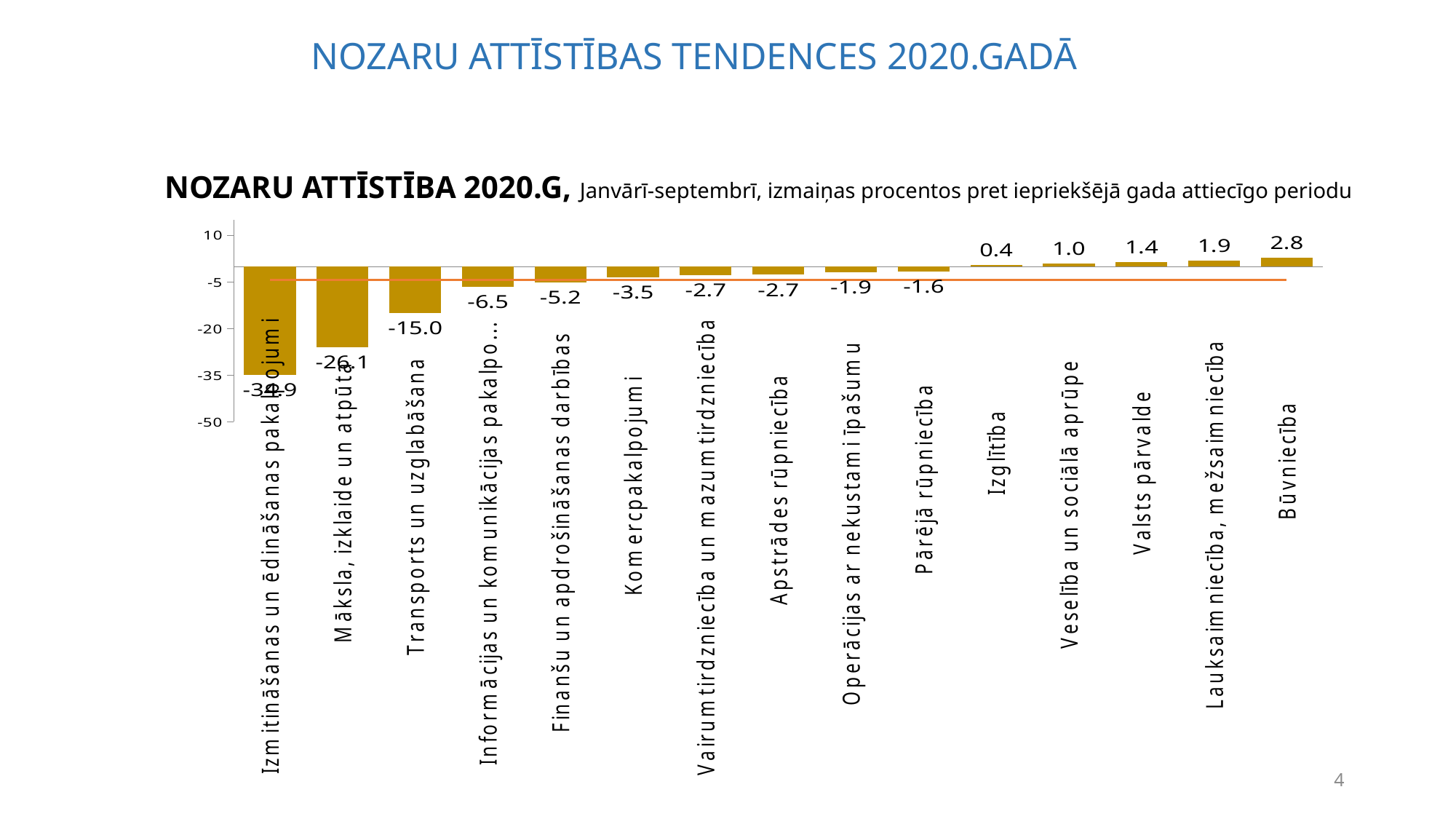
What is the value for Būvniecība? 2.8 How many categories are shown in the chart? 15 What is the value for Māksla, izklaide un atpūta? -26.1 What is the value for Izglītība? 0.4 What is the value for Finanšu un apdrošināšanas darbības? -5.2 Is the value for Izmitināšanas un ēdināšanas pakalpojumi greater or less than -20? less Which is larger, the value for Transports un uzglabāšana or the value for Māksla, izklaide un atpūta? Transports un uzglabāšana What kind of chart is shown on the slide? combination bar and line chart Which category has the lowest value? Izmitināšanas un ēdināšanas pakalpojumi What is the value for Transports un uzglabāšana? -15.0 What is the difference between the values for Būvniecība and Lauksaimniecība, mežsaimniecība? 0.9 Which category has the highest value? Būvniecība